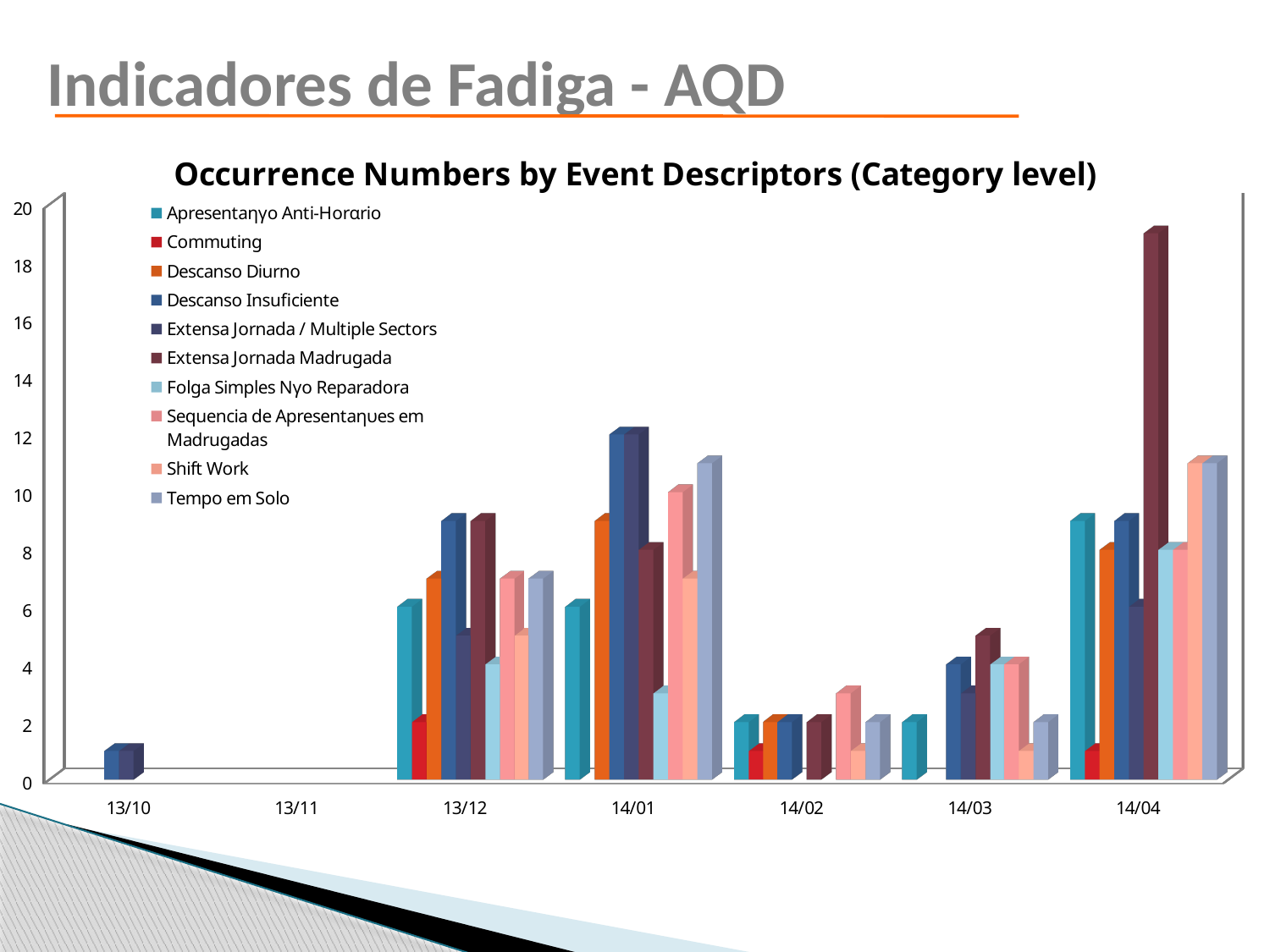
Is the value for Descanso Insuficiente larger in 14/01 or in 13/12? 14/01 Is the value for Tempo em Solo in 14/01 greater or less than 8? greater Which month shows no bars at all? 13/11 Is the value for Commuting in 13/12 greater or less than 4? less Is the value for Extensa Jornada Madrugada in 14/04 greater or less than 16? greater Which series has the tallest bar in 14/04? Extensa Jornada Madrugada Which month has the tallest bar in the chart? 14/04 How many month categories are shown on the x axis? 7 What is the title of the chart? Occurrence Numbers by Event Descriptors (Category level) How many series does the legend list? 10 What kind of chart is shown on the slide? bar chart